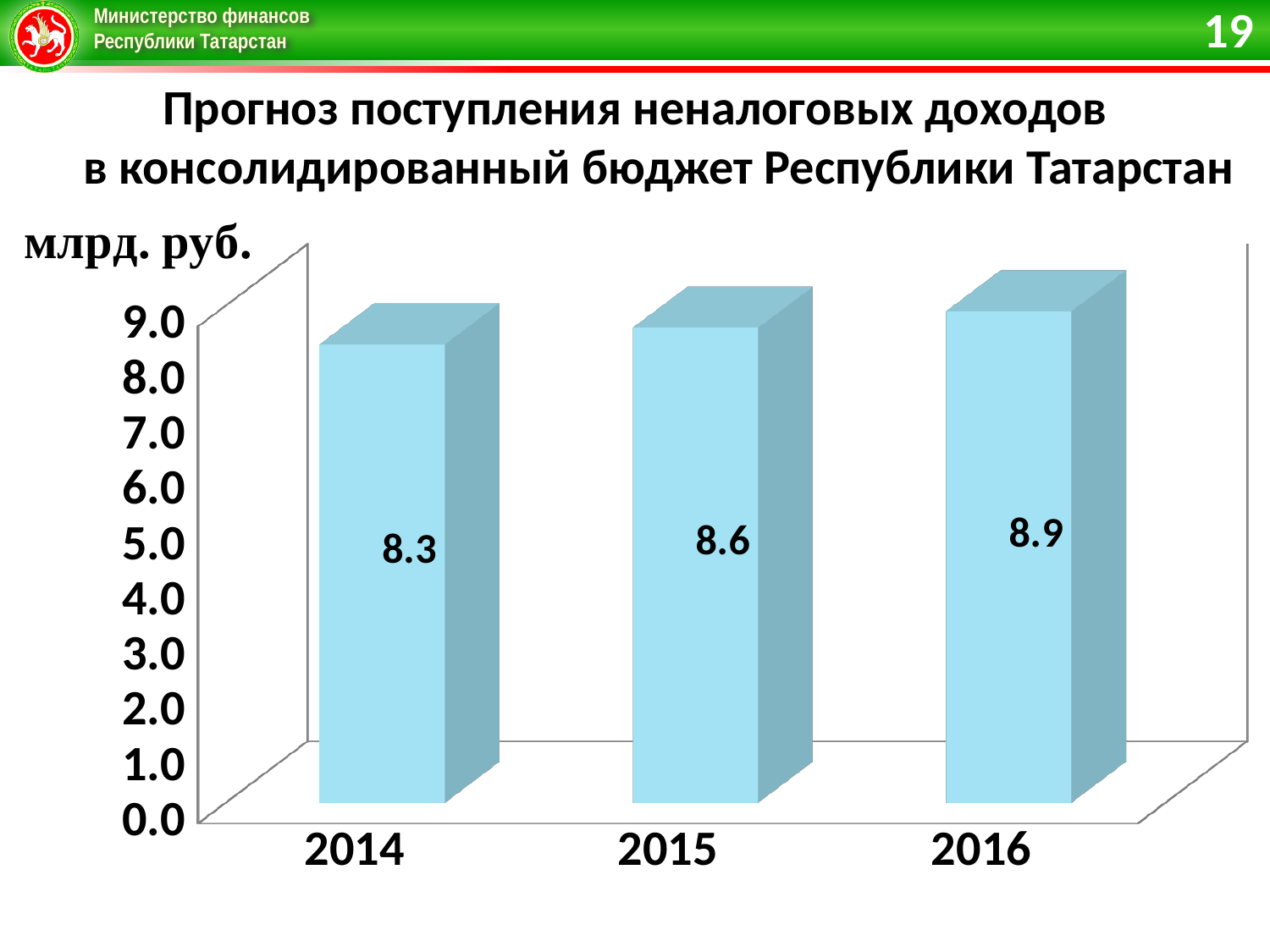
Is the value for 2014 greater or less than 9.0? less What kind of chart is shown on the slide? bar chart What is the forecast value for 2016? 8.9 Which year has the lowest forecast value? 2014 Do the values rise or fall from 2014 to 2016? rise What is the difference between the values for 2015 and 2014? 0.3 How many years are shown on the chart? 3 What is the forecast value for 2015? 8.6 Which is larger, the value for 2015 or the value for 2016? 2016 Which year has the highest forecast value? 2016 What is the difference between the values for 2016 and 2014? 0.6 What is the forecast value for 2014? 8.3